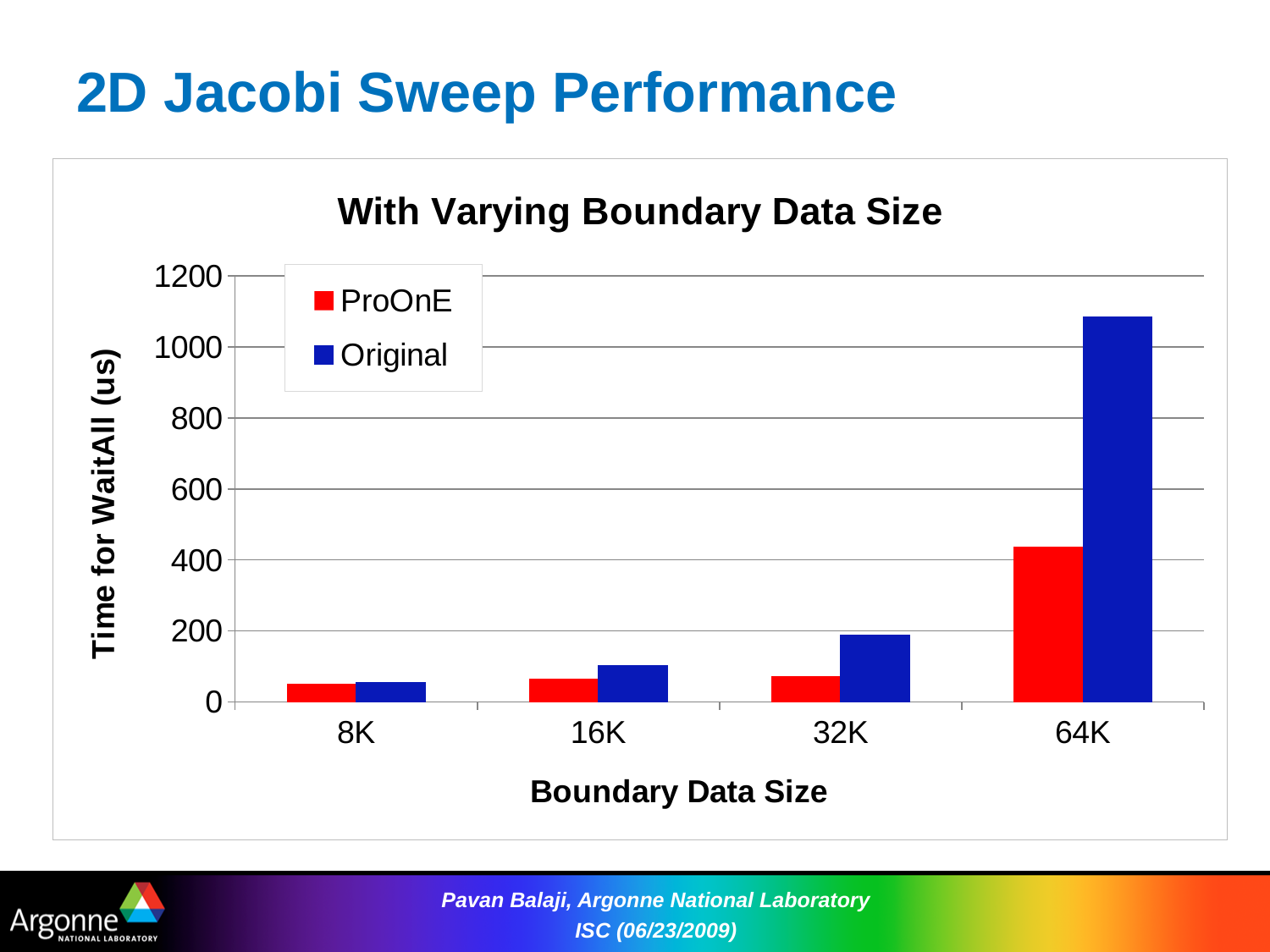
Which boundary data size has the highest Original time for WaitAll? 64K How many series does the legend list? 2 Is the Original value at 64K greater or less than 1000? greater What is the label of the y axis? Time for WaitAll (us) Which boundary data size has the highest ProOnE time for WaitAll? 64K Which boundary data size has the lowest Original time for WaitAll? 8K Is the ProOnE value at 64K greater or less than 600? less Do the Original values rise or fall as the boundary data size increases from 8K to 64K? rise What kind of chart is shown on the slide? bar chart Is the Original value at 32K greater or less than 400? less At 64K, which series has the larger time for WaitAll, ProOnE or Original? Original How many boundary data size categories are shown on the x axis? 4